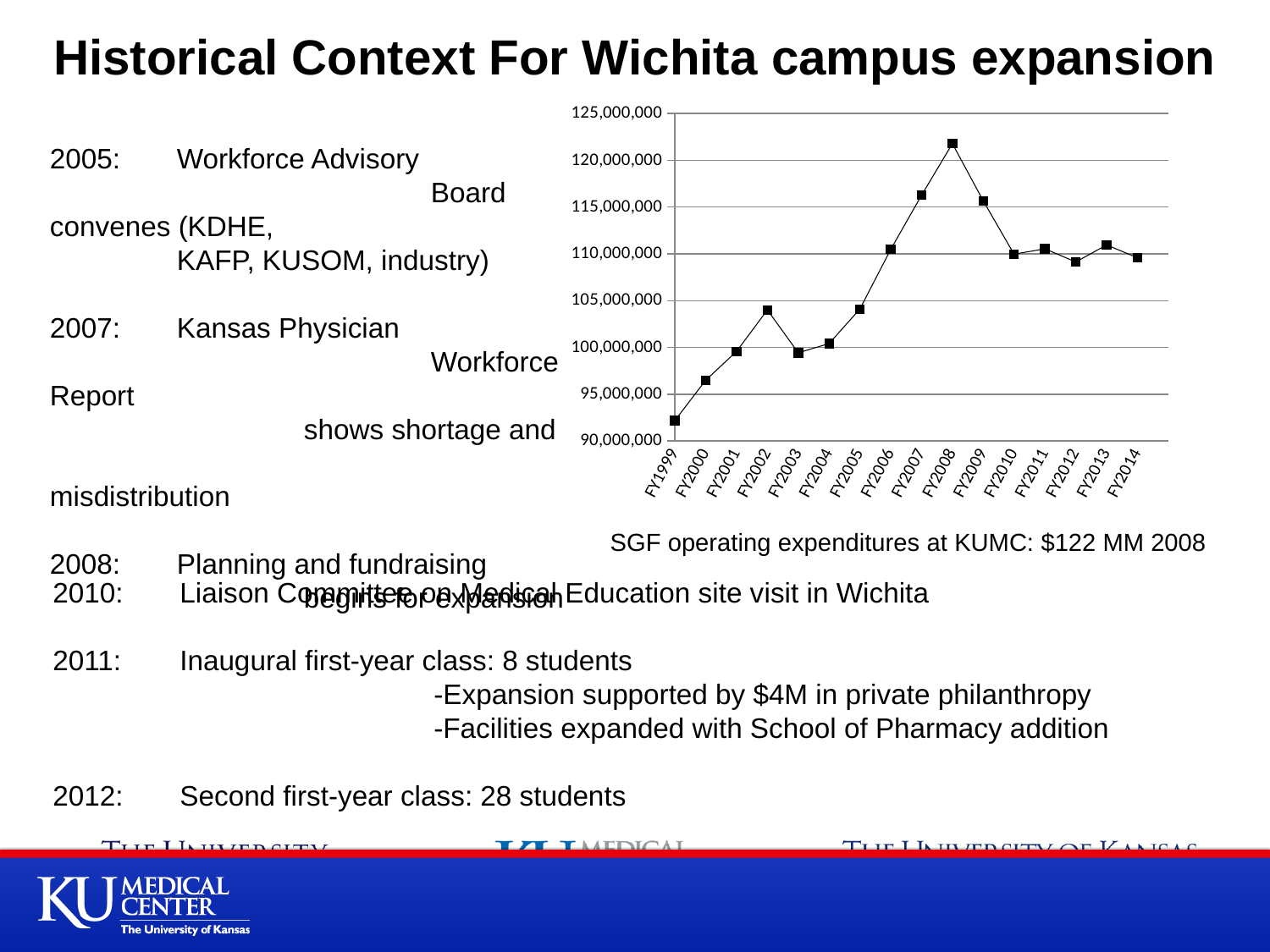
Which is larger, the value for FY2002 or the value for FY2003? FY2002 Do the values rise or fall from FY2008 to FY2010? fall Which fiscal year has the highest value in the chart? FY2008 What is the highest value shown on the chart's y axis? 125,000,000 What kind of chart is shown on the slide? line chart Which fiscal year has the lowest value in the chart? FY1999 Is the value for FY2008 greater or less than 120,000,000? greater How many fiscal years are plotted on the x axis of the chart? 16 Is the value for FY1999 greater or less than 95,000,000? less Is the value for FY2007 greater or less than 115,000,000? greater Do the values rise or fall from FY1999 to FY2008? rise